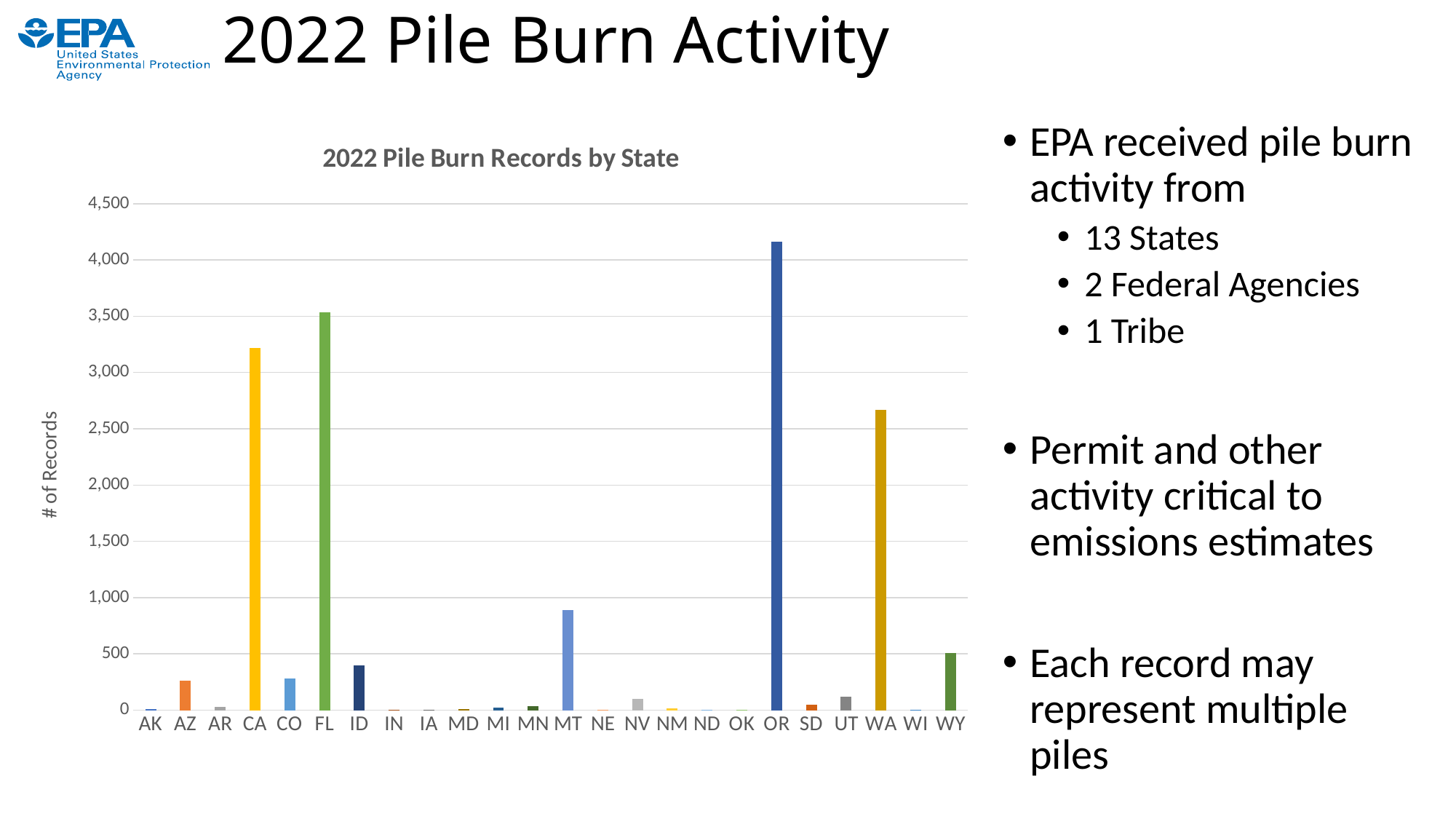
How many states are shown on the x axis of the chart? 24 Is the value for CA greater or less than 3,000? greater What is the title of the chart? 2022 Pile Burn Records by State Is the value for MT greater or less than 1,000? less Is the value for WA greater or less than 3,000? less What kind of chart is shown on the slide? bar chart What is the label on the vertical axis of the chart? # of Records Which has more records, FL or CA? FL Which has more records, MT or ID? MT Which state has the highest number of records in the chart? OR